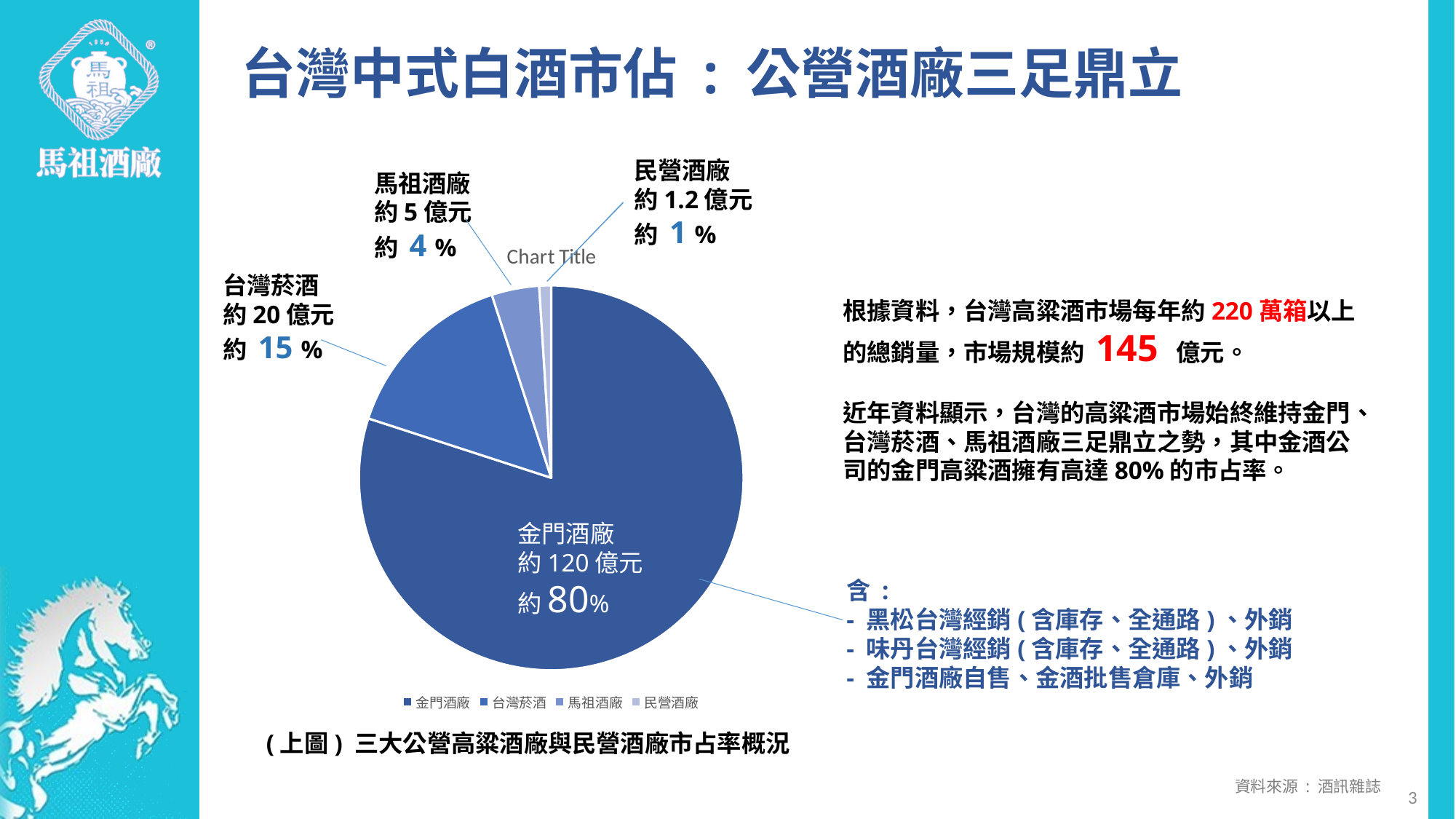
Which category has the smallest slice in the pie chart? 民營酒廠 How many entries does the pie chart's legend list? 4 What amount in 億元 is shown for 金門酒廠 in the pie chart? 約 120 億元 Which category has the largest slice in the pie chart? 金門酒廠 What kind of chart is shown on the slide? Pie chart What amount in 億元 is shown for 民營酒廠 in the pie chart? 約 1.2 億元 What market share percentage is shown for 馬祖酒廠 in the pie chart? 4% What market share percentage is shown for 台灣菸酒 in the pie chart? 15% How many slices does the pie chart have? 4 What is the difference in percentage points between the 金門酒廠 share and the 台灣菸酒 share? 65 What market share percentage is shown for 金門酒廠 in the pie chart? 80% Which has a larger share in the pie chart, 台灣菸酒 or 馬祖酒廠? 台灣菸酒